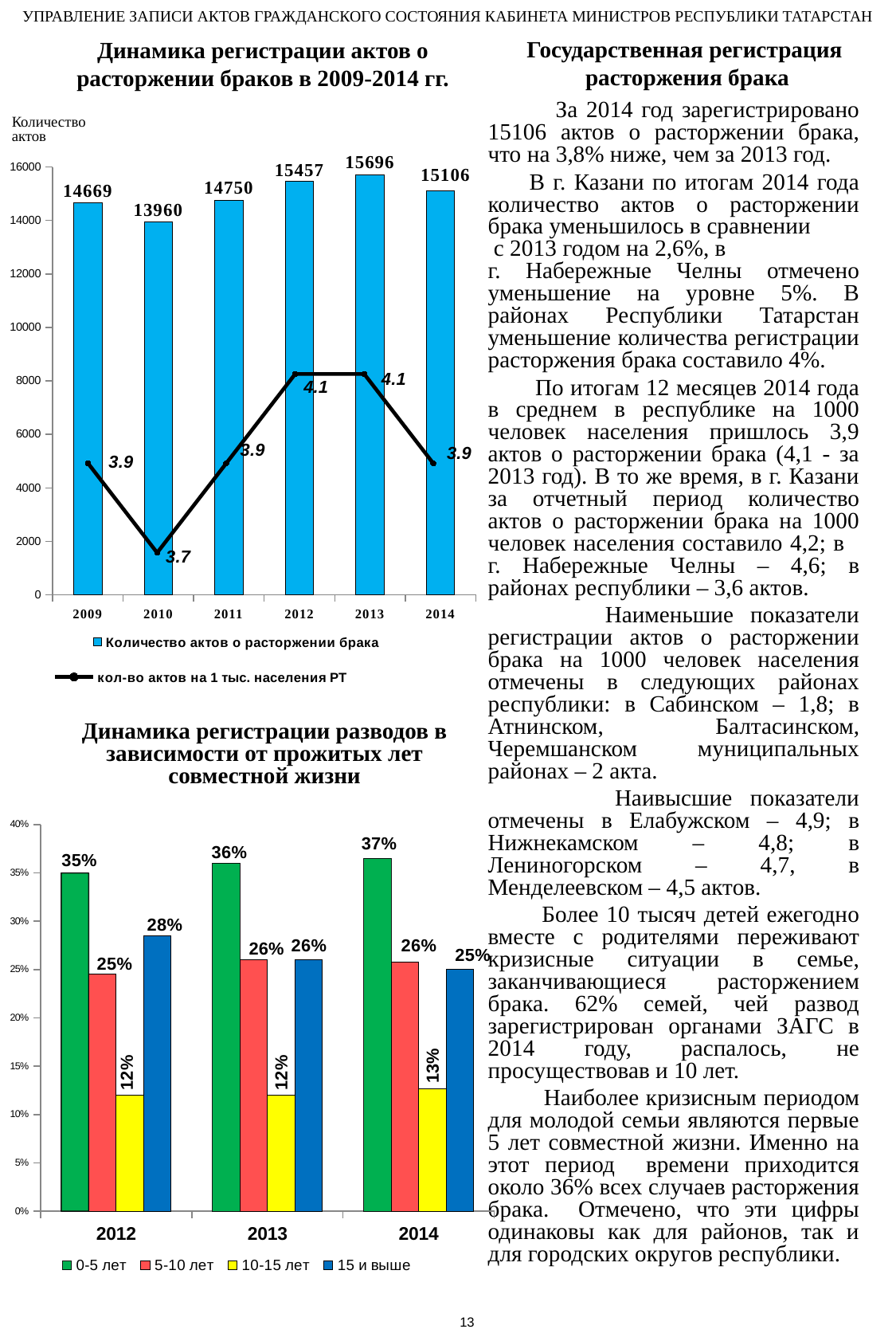
In the chart 'Динамика регистрации актов о расторжении браков в 2009-2014 гг.', how many divorce acts were registered in 2013? 15696 In the chart 'Динамика регистрации разводов в зависимости от прожитых лет совместной жизни', what is the value for '15 и выше' in 2012? 28% In the chart 'Динамика регистрации актов о расторжении браков в 2009-2014 гг.', what is the difference between the number of divorce acts in 2013 and in 2014? 590 In the chart 'Динамика регистрации актов о расторжении браков в 2009-2014 гг.', which year has the highest number of divorce acts? 2013 In the chart 'Динамика регистрации разводов в зависимости от прожитых лет совместной жизни', what is the value for '0-5 лет' in 2014? 37% In the chart 'Динамика регистрации разводов в зависимости от прожитых лет совместной жизни', which series has the lowest value in 2013? 10-15 лет In the chart 'Динамика регистрации актов о расторжении браков в 2009-2014 гг.', how many series does the legend list? 2 In the chart 'Динамика регистрации разводов в зависимости от прожитых лет совместной жизни', is the value for '5-10 лет' in 2012 larger or smaller than the value for '15 и выше' in 2012? smaller In the chart 'Динамика регистрации актов о расторжении браков в 2009-2014 гг.', which year has the lowest number of divorce acts? 2010 In the chart 'Динамика регистрации актов о расторжении браков в 2009-2014 гг.', what is the value of 'кол-во актов на 1 тыс. населения РТ' for 2010? 3.7 What kind of chart is 'Динамика регистрации разводов в зависимости от прожитых лет совместной жизни'? bar chart In the chart 'Динамика регистрации актов о расторжении браков в 2009-2014 гг.', how many years are shown on the x axis? 6